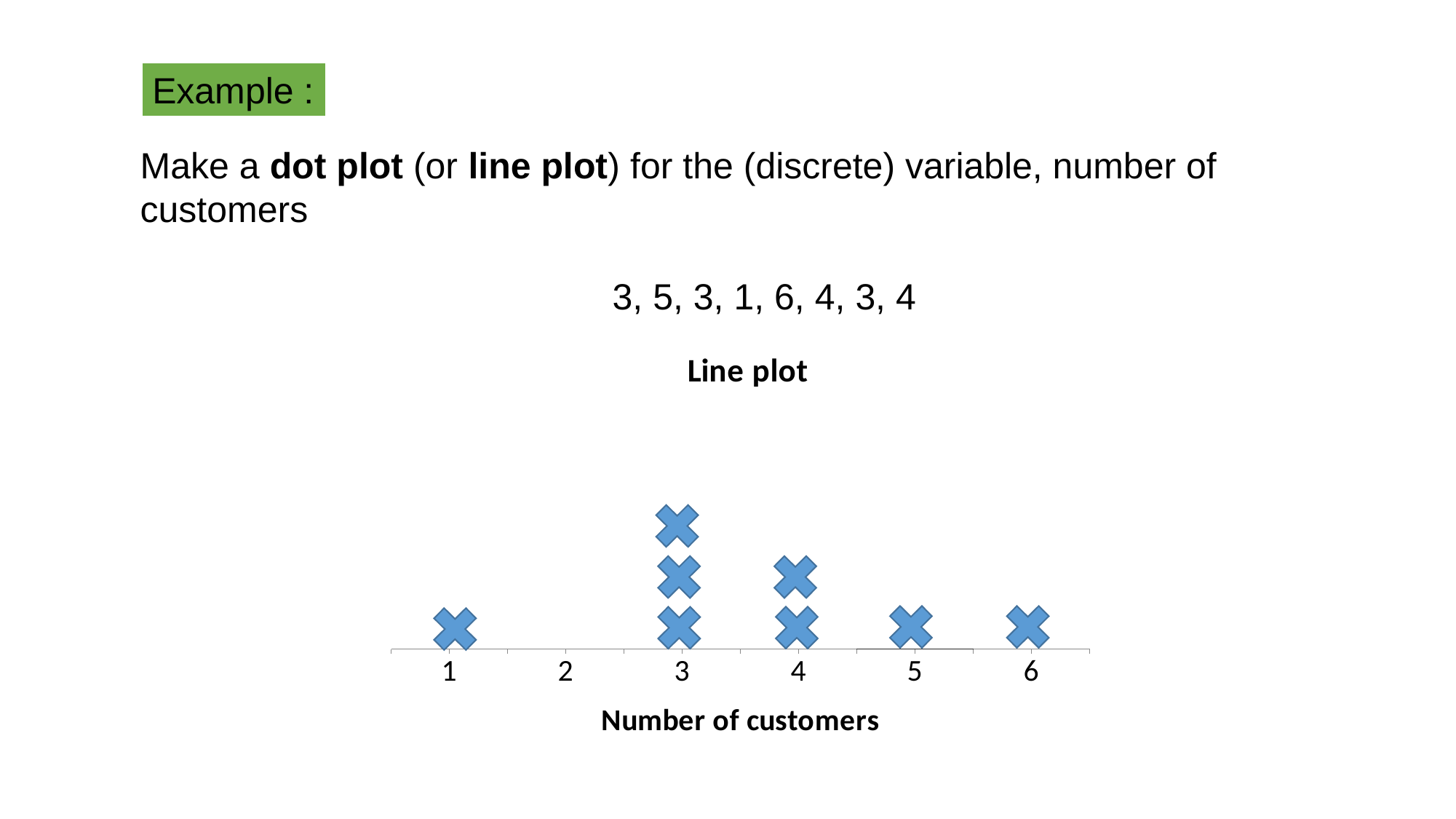
Which number of customers has the most markers? 3 Which number of customers on the axis has no markers at all? 2 How many markers are plotted above the value 1? 1 How many values are labelled on the x axis? 6 How many markers are plotted above the value 3? 3 What kind of chart is shown on the slide? dot plot How many more markers are there above 3 than above 4? 1 What is the label of the x axis? Number of customers What is the title of the chart? Line plot How many markers are plotted in total on the chart? 8 How many markers are plotted above the value 4? 2 Which has more markers, 3 or 4? 3